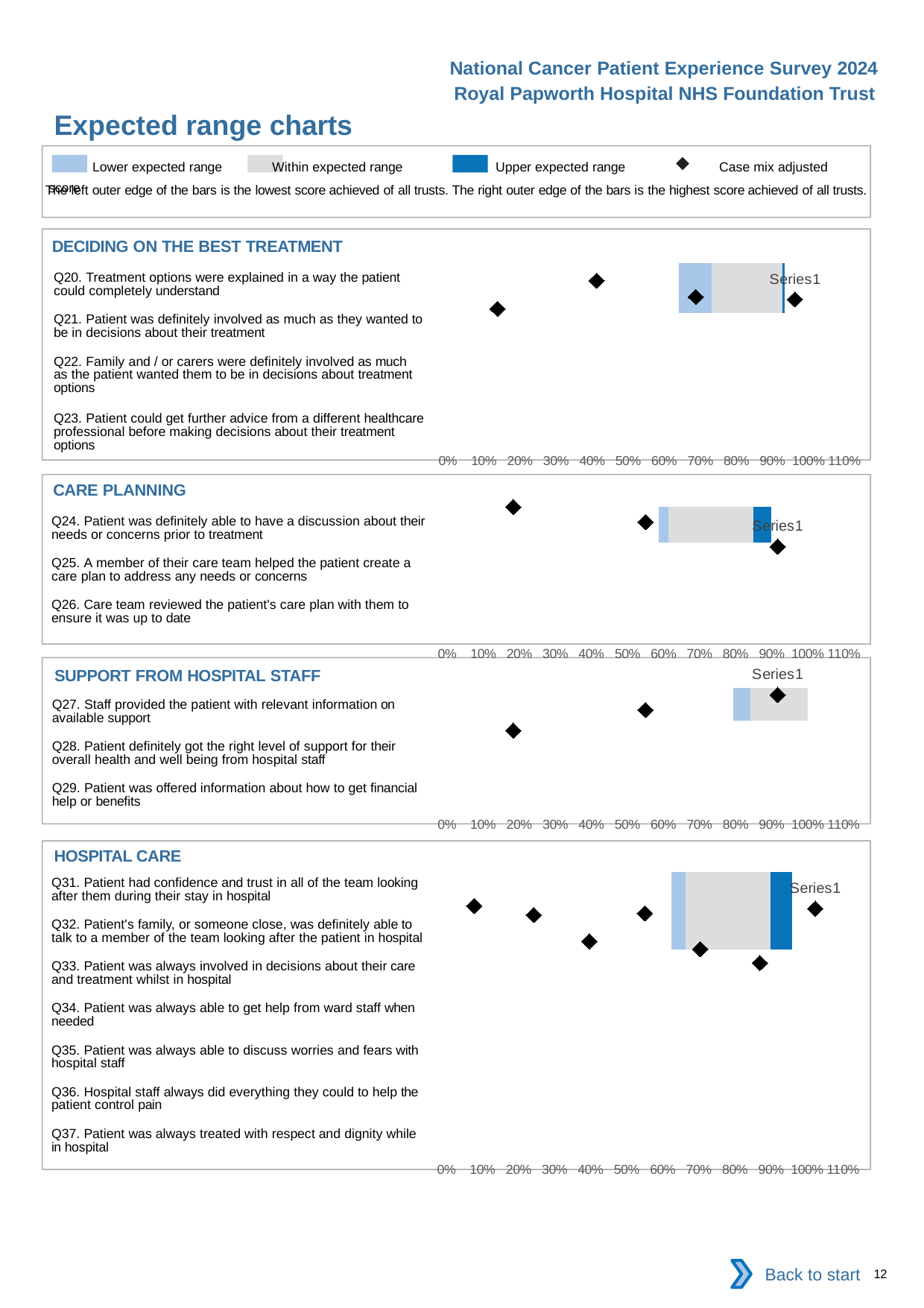
In the HOSPITAL CARE chart, how many diamond markers are plotted? 7 According to the legend, what does the diamond marker represent? Case mix adjusted score According to the legend, what does the dark blue colour represent? Upper expected range How many expected range charts are shown on the slide? 4 In the CARE PLANNING chart, is the leftmost diamond marker greater or less than 30%? less In the HOSPITAL CARE chart, is the leftmost diamond marker greater or less than 20%? less In the SUPPORT FROM HOSPITAL STAFF chart, how many survey questions are listed? 3 In the DECIDING ON THE BEST TREATMENT chart, is the rightmost diamond marker greater or less than 90%? greater